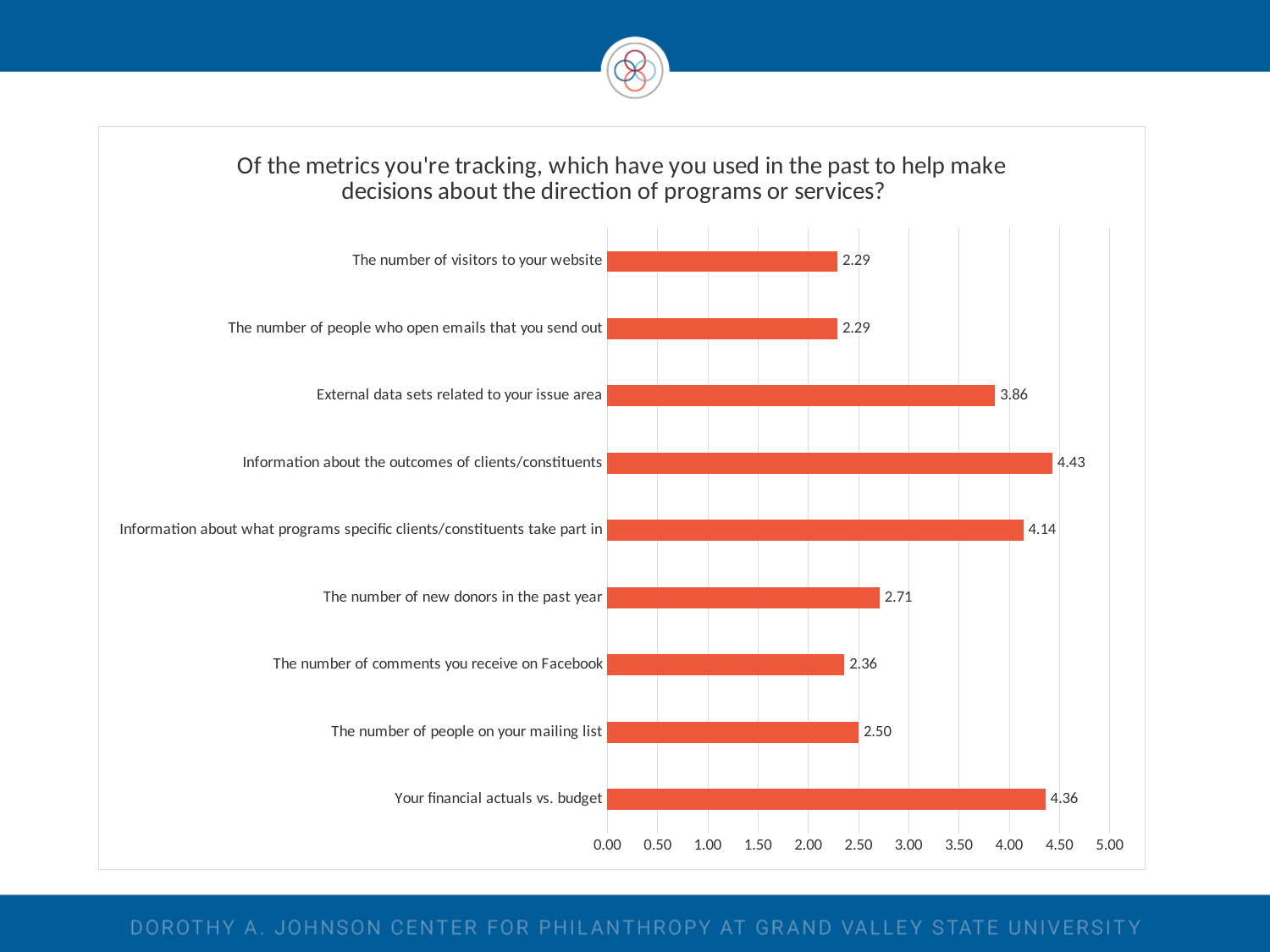
How many categories are shown in the chart? 9 What value is shown for 'The number of people who open emails that you send out'? 2.29 What is the value for 'External data sets related to your issue area'? 3.86 Which category has the highest value? Information about the outcomes of clients/constituents What is the maximum value shown on the x axis? 5.00 What is the value for 'The number of new donors in the past year'? 2.71 What is the difference between the values for 'Information about the outcomes of clients/constituents' and 'Your financial actuals vs. budget'? 0.07 What is the difference between the values for 'External data sets related to your issue area' and 'The number of visitors to your website'? 1.57 Is the value for 'Information about what programs specific clients/constituents take part in' greater or less than 4.00? greater What kind of chart is shown on the slide? Bar chart What is the value for 'Your financial actuals vs. budget'? 4.36 Which is larger: the value for 'The number of people on your mailing list' or 'The number of comments you receive on Facebook'? The number of people on your mailing list